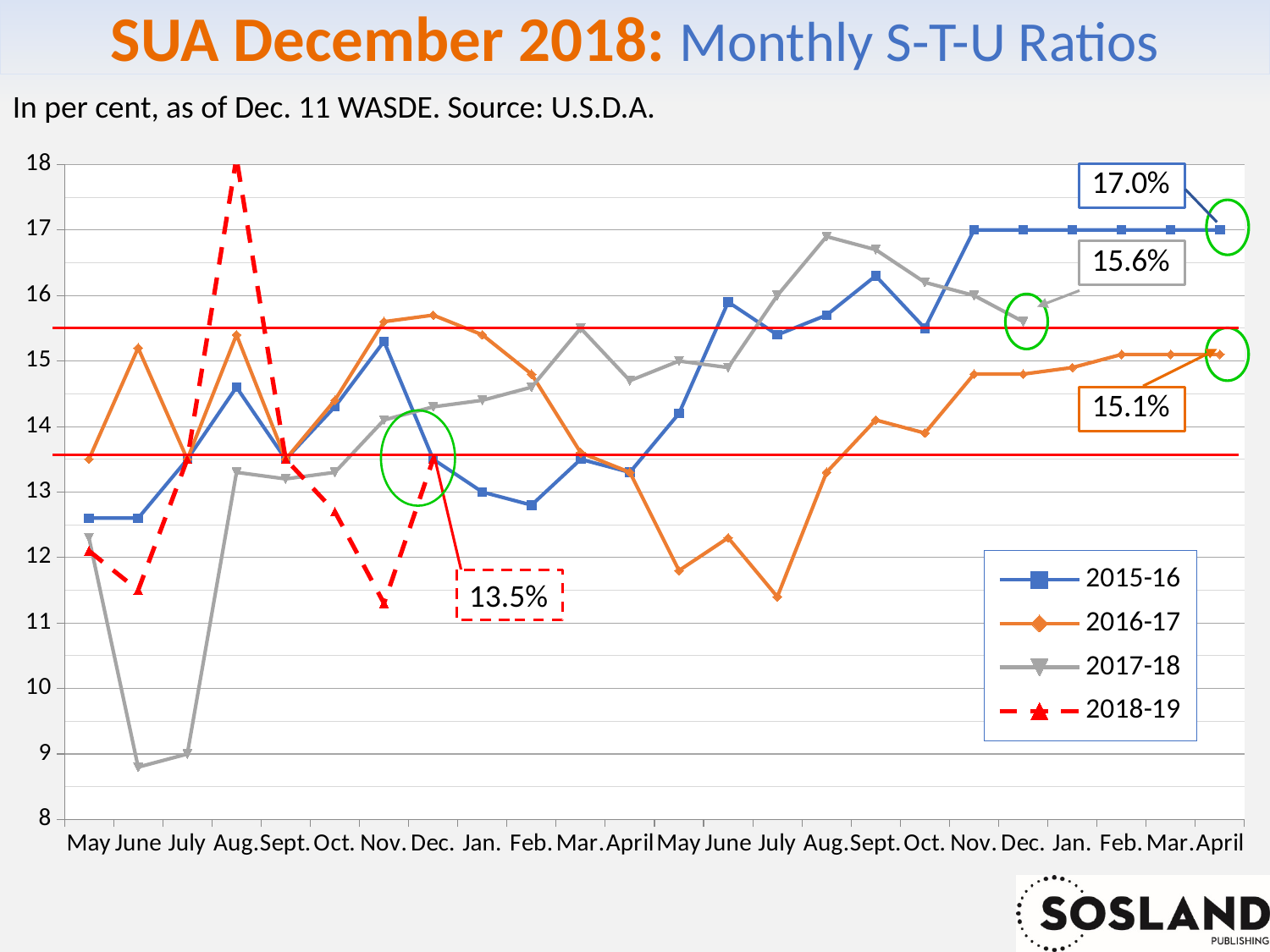
What is the labelled value of the 2018-19 series at the first Dec. point? 13.5% Which series is drawn as a red dashed line? 2018-19 At the final April point, which series is higher: 2015-16 or 2016-17? 2015-16 Is the value for the 2017-18 series at the first June point greater or less than 10? less What is the difference between the labelled final April values of the 2015-16 series (17.0%) and the 2016-17 series (15.1%)? 1.9 percentage points How many month labels are shown along the x axis? 24 How many series does the legend list? 4 Is the value for the 2018-19 series at the first Aug. point greater or less than 17? greater What is the labelled value of the 2015-16 series at the final April point? 17.0% What is the labelled value of the 2017-18 series at the second Dec. point? 15.6% What is the labelled value of the 2016-17 series at the final April point? 15.1% What kind of chart is shown on the slide? line chart